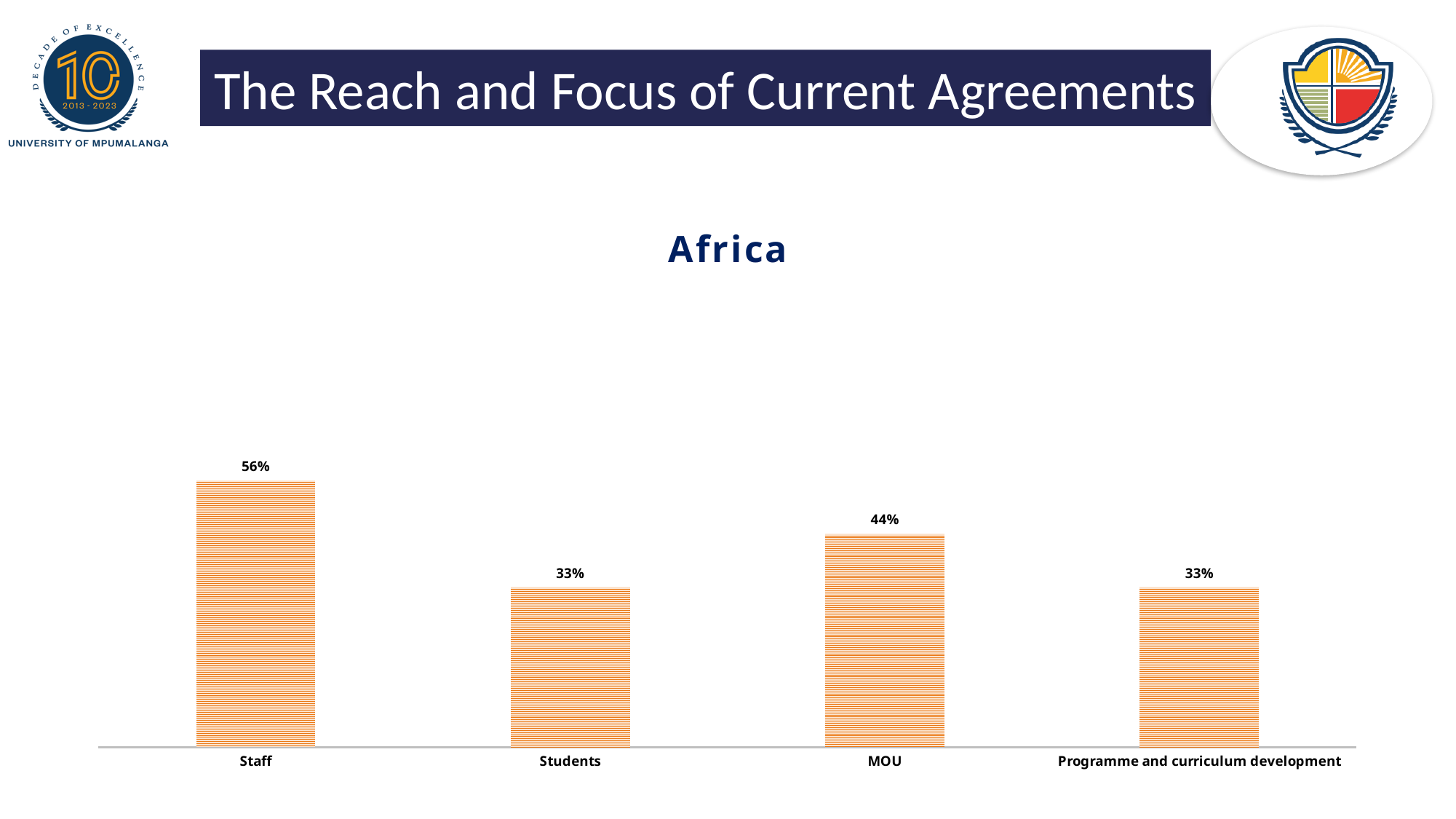
What is the value for Staff? 56% What is the title of the chart? Africa Which category has the highest value? Staff What is the value for MOU? 44% What is the value for Students? 33% How many categories are shown in the chart? 4 What is the difference between the values for Staff and MOU? 12% What is the difference between the values for Staff and Students? 23% What kind of chart is shown on the slide? Bar chart What is the value for Programme and curriculum development? 33% What colour are the bars in the chart? Orange Which is larger, the value for MOU or the value for Students? MOU